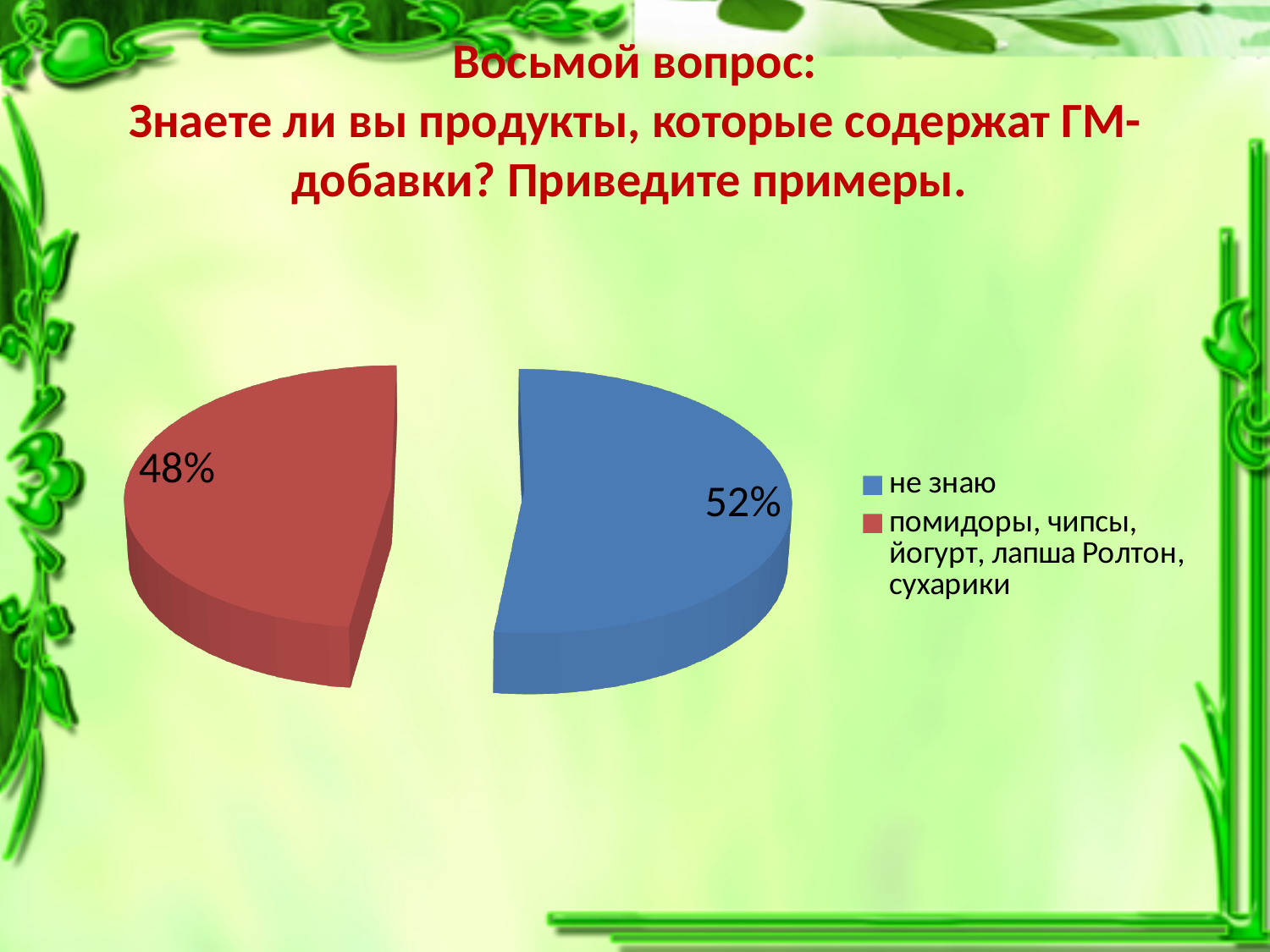
How many entries does the legend list? 2 How many slices does the pie chart have? 2 What kind of chart is shown on the slide? pie chart Which slice is the largest in the pie chart? не знаю Which is larger: the "не знаю" slice or the "помидоры, чипсы, йогурт, лапша Ролтон, сухарики" slice? не знаю What colour is the "не знаю" slice? blue Which slice is the smallest in the pie chart? помидоры, чипсы, йогурт, лапша Ролтон, сухарики Is the share of the "не знаю" slice greater or less than 50%? greater What is the difference in percentage points between the "не знаю" slice and the "помидоры, чипсы, йогурт, лапша Ролтон, сухарики" slice? 4% What share of the pie does the "не знаю" slice represent? 52% What share of the pie does the "помидоры, чипсы, йогурт, лапша Ролтон, сухарики" slice represent? 48% What colour is the "помидоры, чипсы, йогурт, лапша Ролтон, сухарики" slice? red